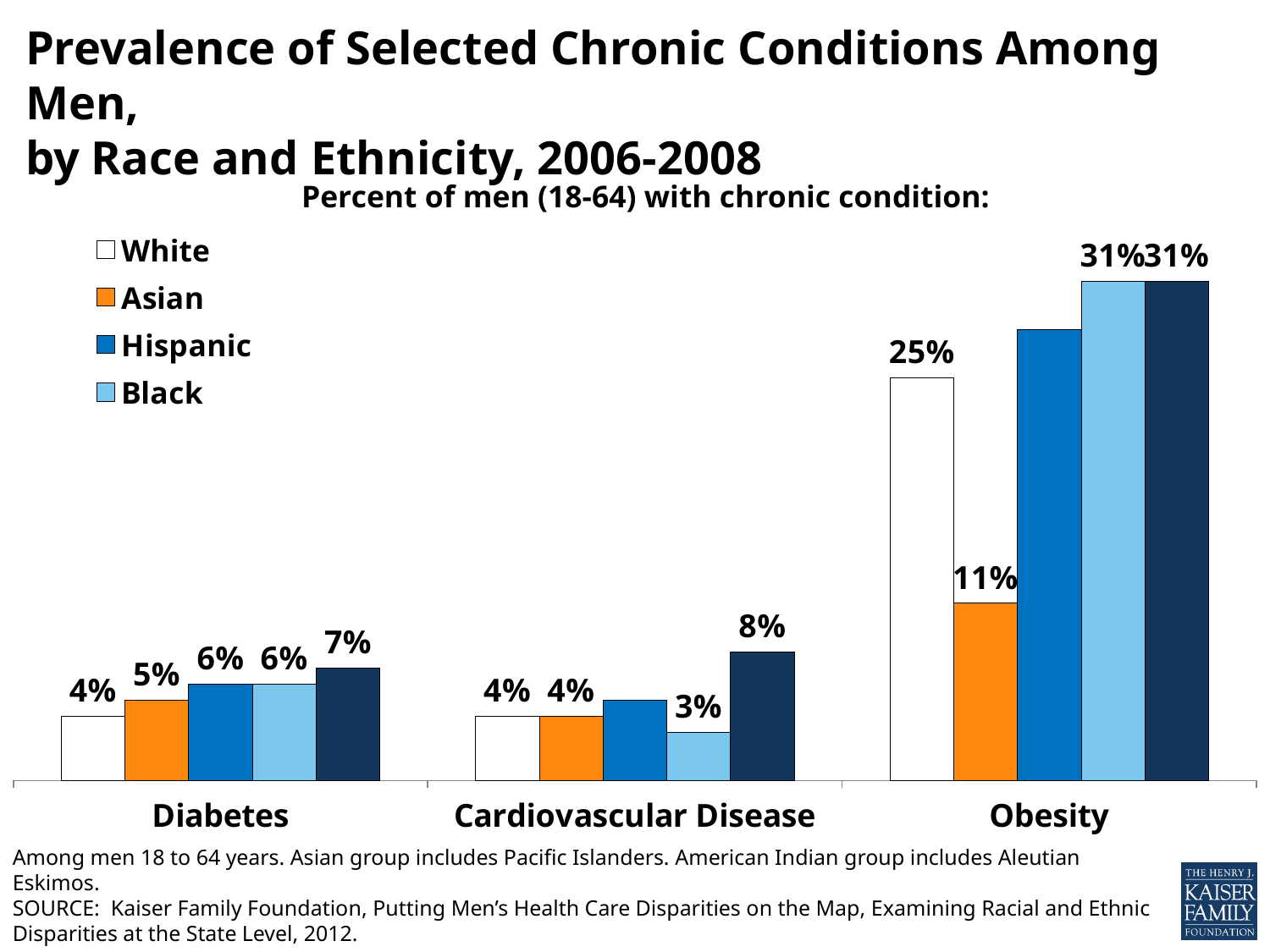
Which condition has the highest value for White men? Obesity How many chronic condition categories are shown on the x axis? 3 Which condition has the lowest value for Asian men? Cardiovascular Disease What is the value for Asian men in the Obesity category? 11% What is the value for White men in the Diabetes category? 4% What is the value for Asian men in the Diabetes category? 5% In the Obesity category, which is larger: the value for Black men or for White men? Black What is the value for Black men in the Obesity category? 31% What is the difference between the White and Asian values in the Obesity category? 14% What kind of chart is shown on the slide? Bar chart How many series does the legend list? 4 What is the value for Black men in the Cardiovascular Disease category? 3%